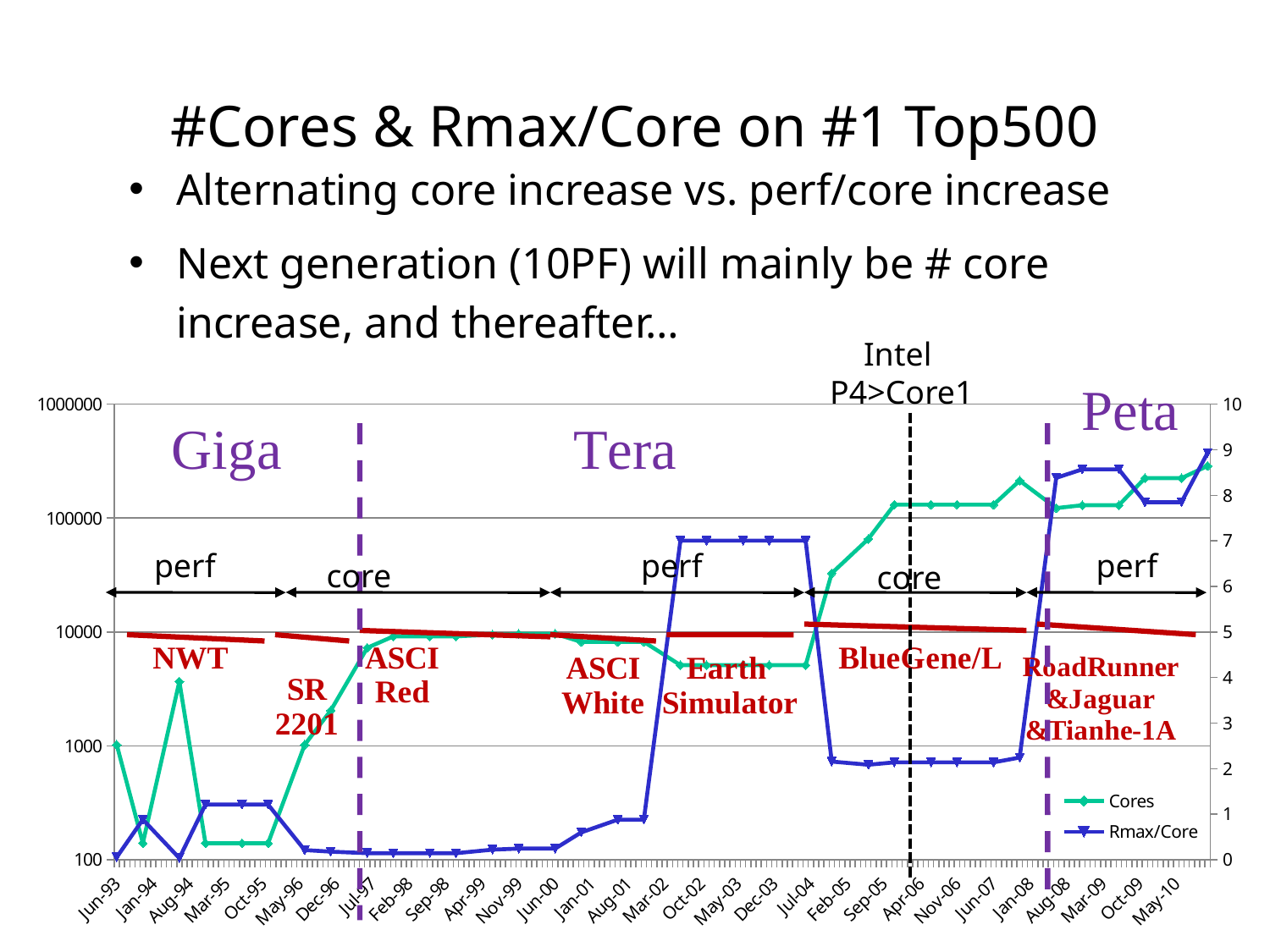
Which is larger for the Cores series: the value at Jun-93 or the value at May-10? May-10 What are the two series named in the legend? Cores and Rmax/Core Does the Rmax/Core series rise or fall between Mar-02 and Oct-02? rise Is the value of the Rmax/Core series at Oct-02 greater or less than 5? greater What kind of chart is shown on the slide? line chart How many series does the legend list? 2 Is the value of the Rmax/Core series at Dec-96 greater or less than 1? less Is the value of the Cores series at Jul-97 greater or less than 10000? less Which is larger for the Rmax/Core series: the value at Oct-02 or the value at Feb-05? Oct-02 What is the title of the slide containing the chart? #Cores & Rmax/Core on #1 Top500